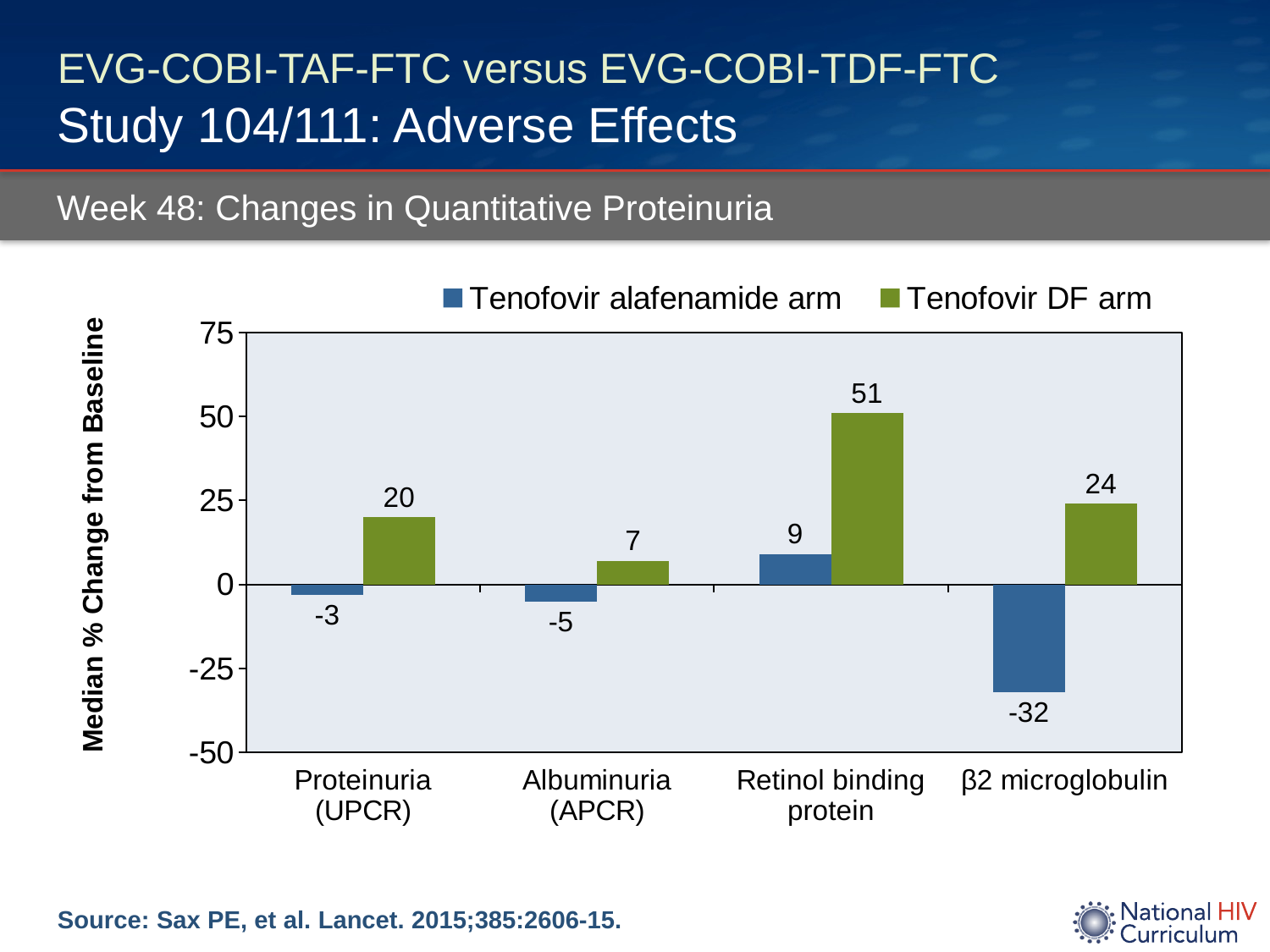
What is the median % change from baseline for Retinol binding protein in the Tenofovir DF arm? 51 Which category has the highest value in the Tenofovir DF arm? Retinol binding protein What is the y-axis label of the chart? Median % Change from Baseline Which category has the lowest value in the Tenofovir alafenamide arm? β2 microglobulin What is the difference between the Tenofovir DF arm and Tenofovir alafenamide arm values for Retinol binding protein? 42 What kind of chart is shown on the slide? Bar chart How many categories are shown on the x axis? 4 How many series does the legend list? 2 What is the median % change from baseline for β2 microglobulin in the Tenofovir alafenamide arm? -32 What is the value for Proteinuria (UPCR) in the Tenofovir alafenamide arm? -3 What is the value for Albuminuria (APCR) in the Tenofovir DF arm? 7 For β2 microglobulin, which arm has the larger value? Tenofovir DF arm